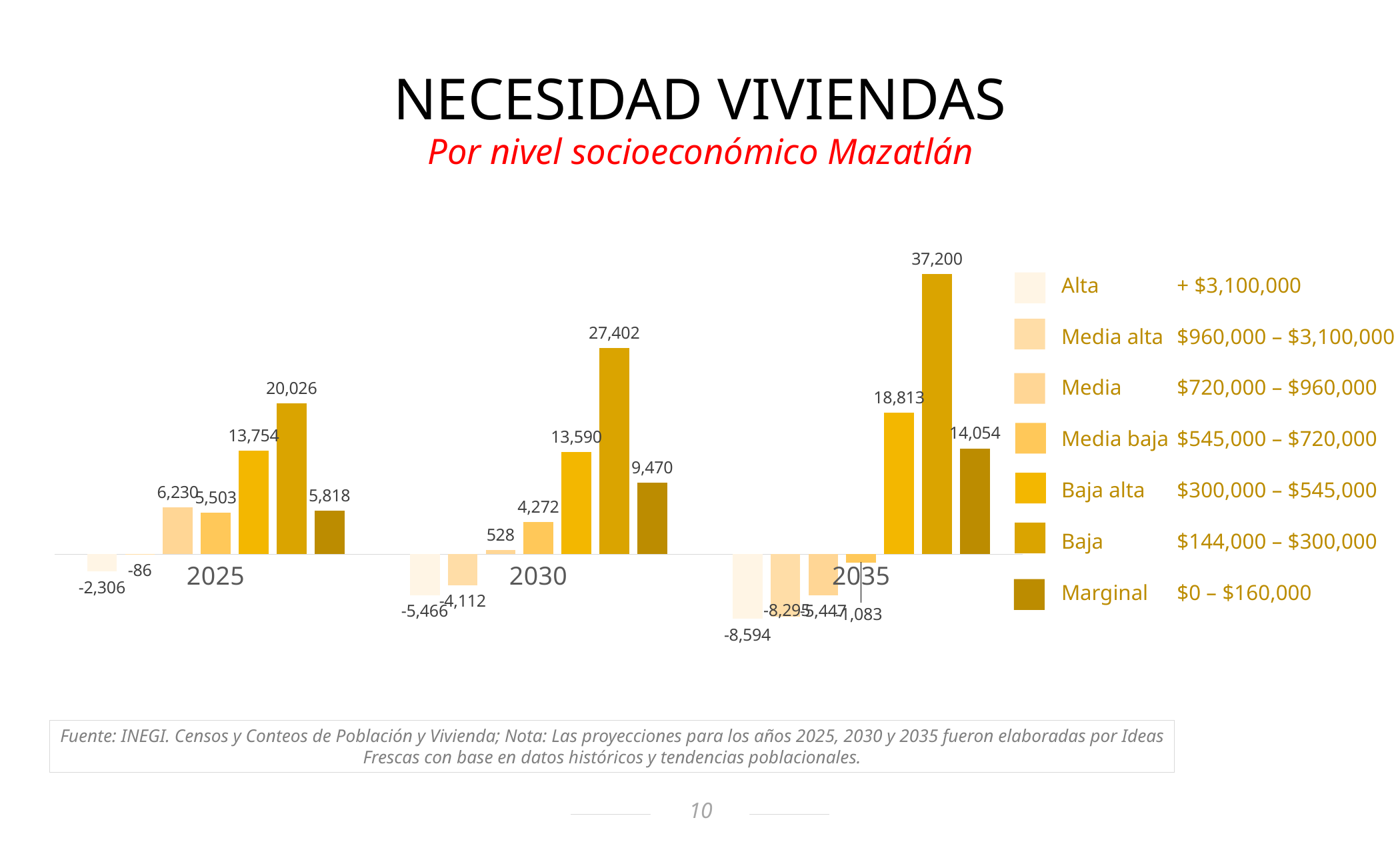
Which is larger, the Baja alta value in 2025 or in 2030? 2025 How many year groups are shown on the x axis? 3 What is the value for Media in 2030? 528 What is the value for Marginal in 2030? 9,470 Which series has the lowest value in 2035? Alta Does the Baja value rise or fall from 2025 to 2035? Rise What is the value for Baja in 2035? 37,200 How many series does the legend list? 7 What is the value for Alta in 2025? -2,306 What is the difference between the Baja value in 2030 and the Baja value in 2025? 7,376 What kind of chart is shown on the slide? Bar chart Which series has the highest value in 2035? Baja